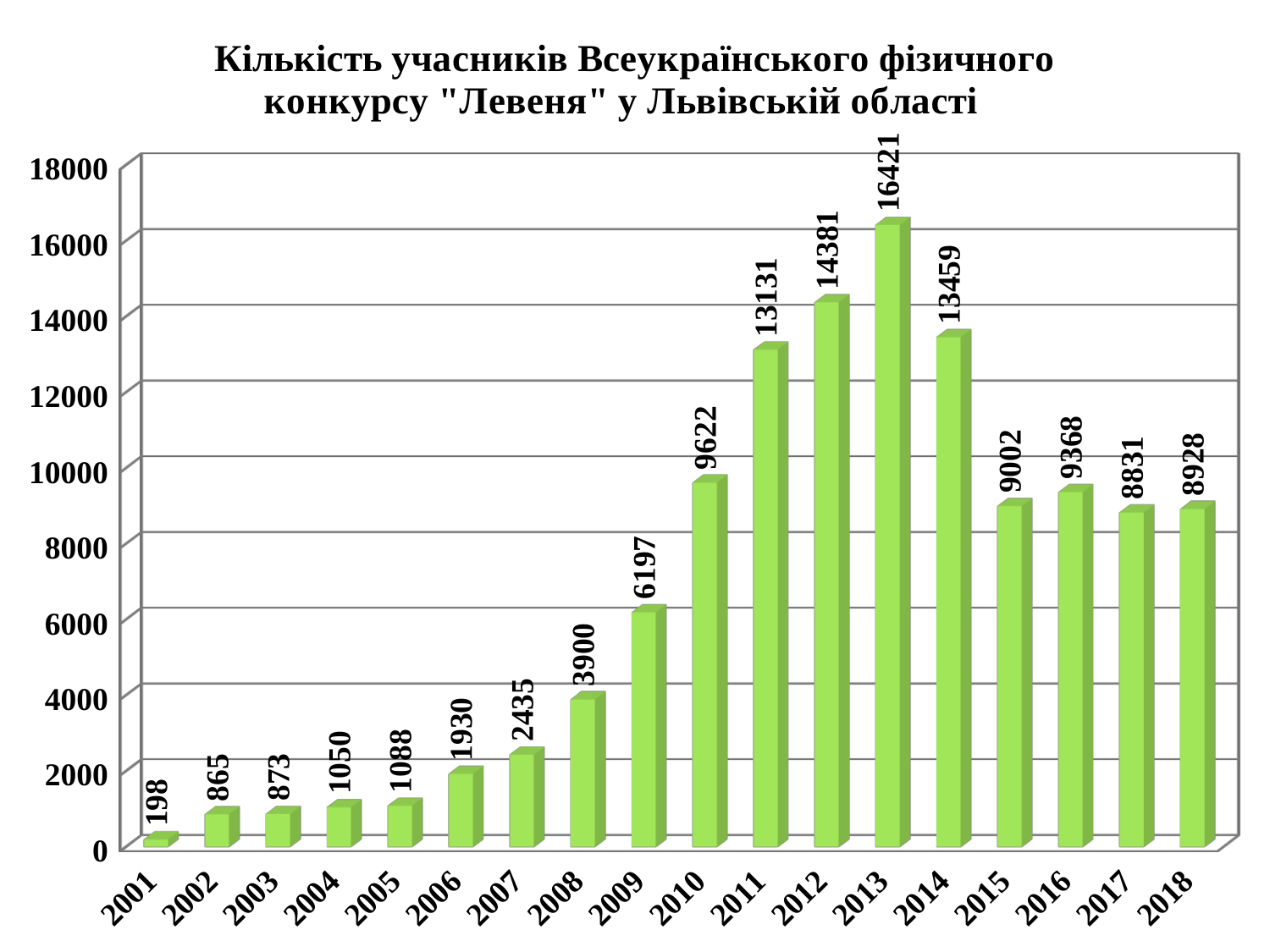
Which year had the highest number of participants? 2013 How many years are shown on the x axis? 18 What was the number of participants in 2013? 16421 What kind of chart is shown on the slide? bar chart Which year had more participants, 2011 or 2012? 2012 Is the value for 2009 greater or less than 6000? greater What was the number of participants in 2010? 9622 Do the values rise or fall from 2001 to 2013? rise What colour are the bars in the chart? green What was the number of participants in 2001? 198 What is the difference between the number of participants in 2013 and in 2014? 2962 Which year had the lowest number of participants? 2001